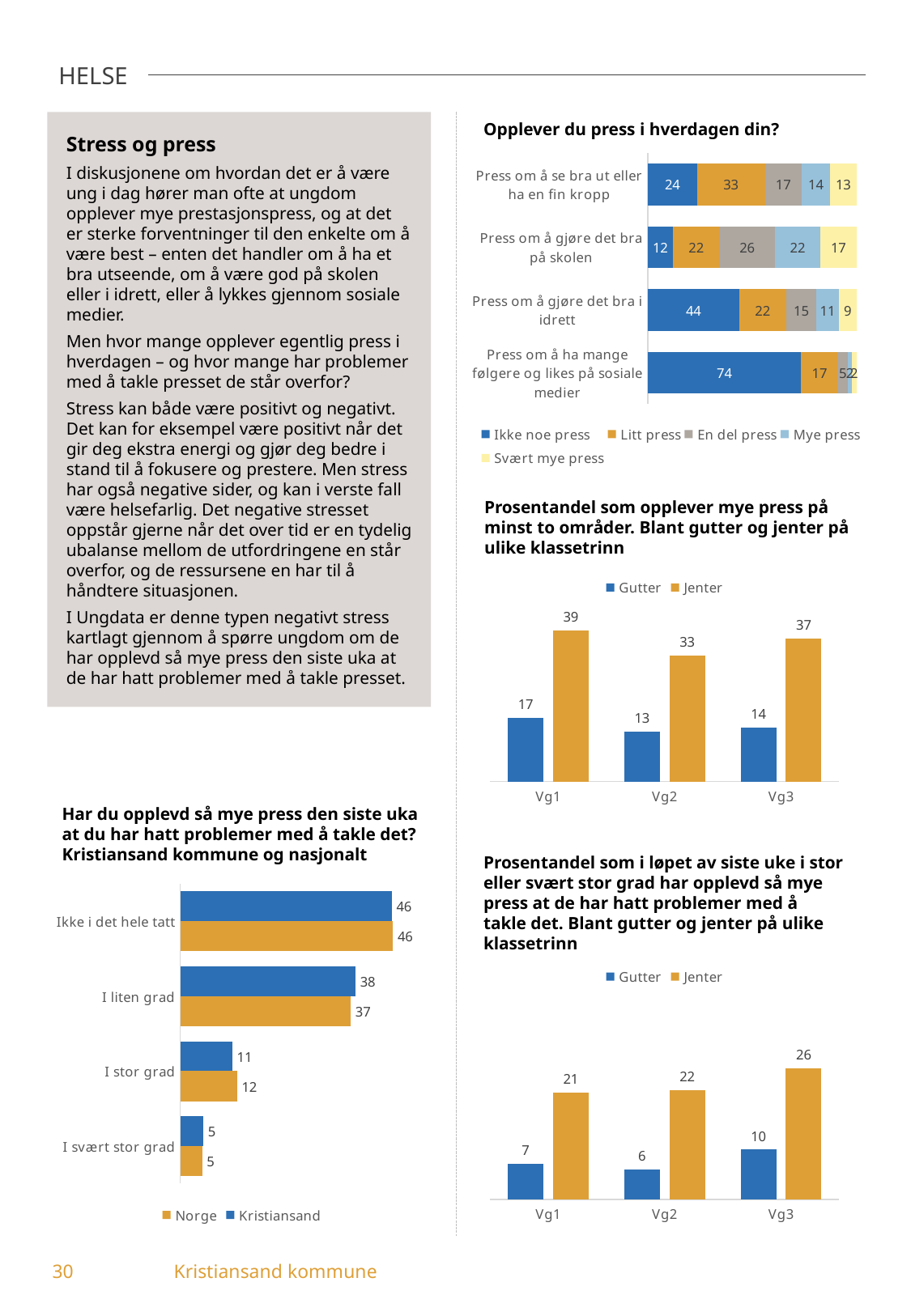
In the chart 'Prosentandel som opplever mye press på minst to områder', what is the difference between Jenter and Gutter at Vg2? 20 In the bottom-right chart 'Prosentandel som i løpet av siste uke i stor eller svært stor grad har opplevd så mye press', what is the value for Jenter at Vg3? 26 In the chart 'Har du opplevd så mye press den siste uka at du har hatt problemer med å takle det?', which is larger for 'I stor grad': Norge or Kristiansand? Norge In the chart 'Prosentandel som opplever mye press på minst to områder', what is the value for Jenter at Vg1? 39 In the chart 'Opplever du press i hverdagen din?', which category has the highest value for 'Ikke noe press'? Press om å ha mange følgere og likes på sosiale medier What kind of chart is the bottom-right chart 'Prosentandel som i løpet av siste uke i stor eller svært stor grad har opplevd så mye press'? Bar chart In the chart 'Opplever du press i hverdagen din?', how many series does the legend list? 5 In the chart 'Har du opplevd så mye press den siste uka at du har hatt problemer med å takle det?', what is the value for Norge for 'I liten grad'? 37 In the chart 'Opplever du press i hverdagen din?', what is the value for 'Litt press' for 'Press om å se bra ut eller ha en fin kropp'? 33 In the chart 'Har du opplevd så mye press den siste uka at du har hatt problemer med å takle det?', how many categories are shown? 4 In the chart 'Opplever du press i hverdagen din?', what is the value for 'Ikke noe press' for 'Press om å gjøre det bra i idrett'? 44 In the chart 'Prosentandel som opplever mye press på minst to områder', which class level has the lowest value for Gutter? Vg2